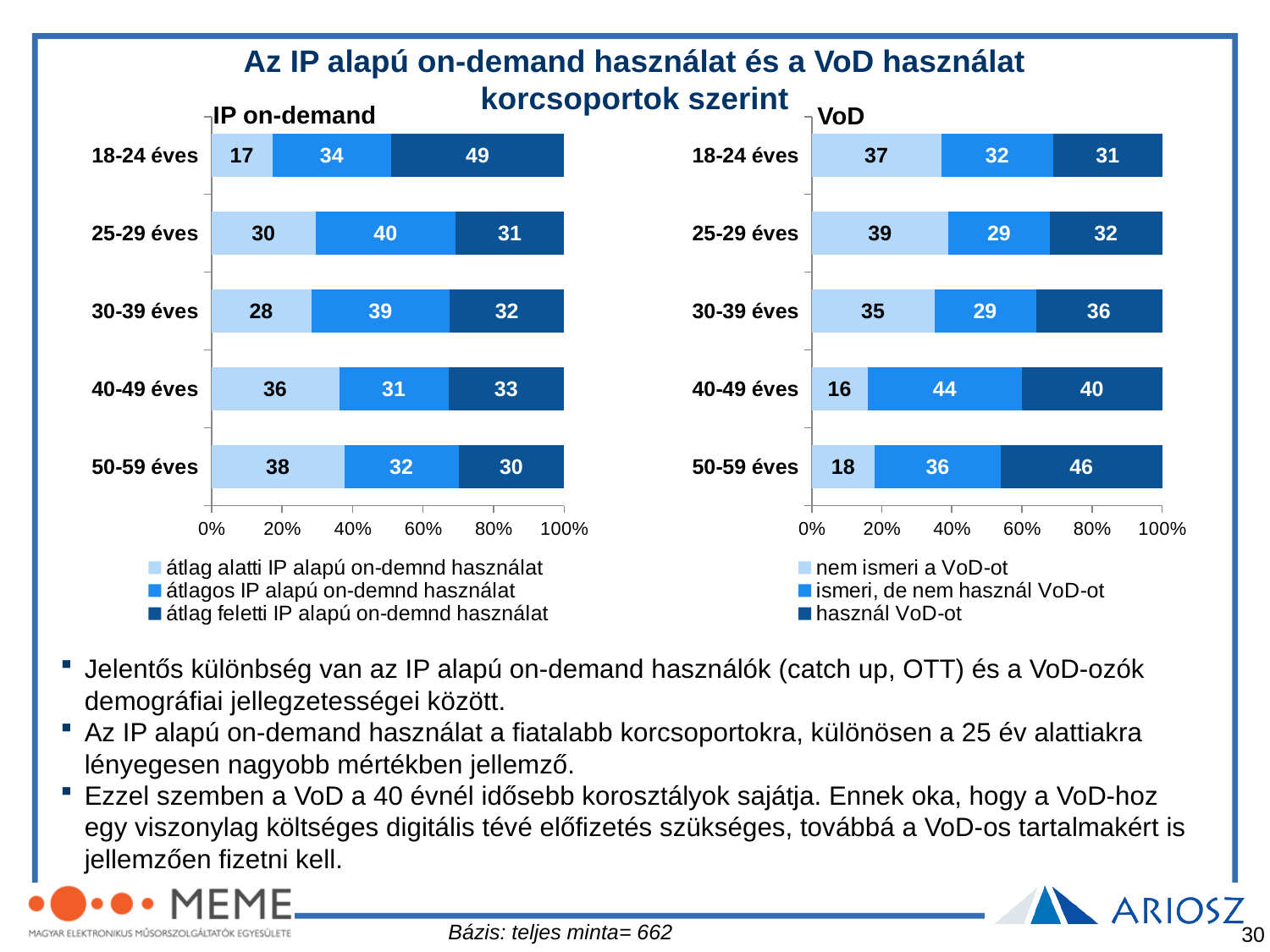
In the IP on-demand chart, what is the value of 'átlag feletti IP alapú on-demnd használat' for 18-24 éves? 49 In the IP on-demand chart, what is the difference between the 'átlag alatti IP alapú on-demnd használat' values for 50-59 éves and 18-24 éves? 21 What type of chart is the VoD chart? Stacked bar chart In the VoD chart, what is the value of 'használ VoD-ot' for 50-59 éves? 46 What is the title of the chart on the right side of the slide? VoD In the VoD chart, which age group has the lowest value for 'nem ismeri a VoD-ot'? 40-49 éves How many age groups are shown in the VoD chart? 5 In the VoD chart, what is the value of 'nem ismeri a VoD-ot' for 40-49 éves? 16 In the VoD chart, what is the total of the stacked bar for 30-39 éves? 100 How many series does the legend of the IP on-demand chart list? 3 In the IP on-demand chart, which age group has the highest value for 'átlag feletti IP alapú on-demnd használat'? 18-24 éves In the VoD chart, which is larger: 'használ VoD-ot' for 40-49 éves or for 25-29 éves? 40-49 éves